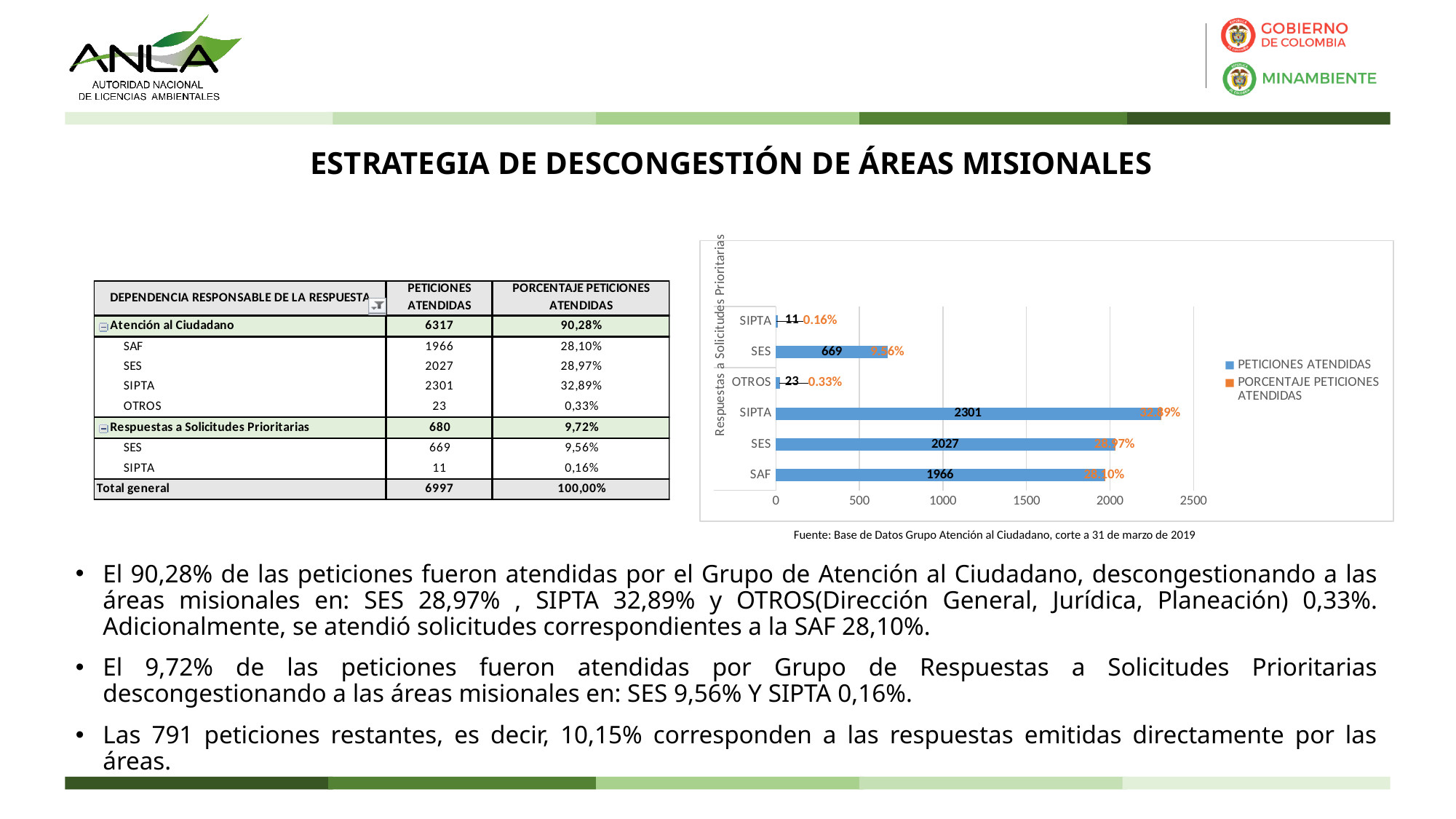
What is the PETICIONES ATENDIDAS value for the SES bar in the Respuestas a Solicitudes Prioritarias group (second bar from the top)? 669 What is the PETICIONES ATENDIDAS value for SAF in the chart? 1966 How many series does the chart legend list? 2 How many bars (categories) are plotted in the chart? 6 What is the PETICIONES ATENDIDAS value for OTROS in the chart? 23 Which bar in the chart has the lowest PETICIONES ATENDIDAS value? SIPTA in the Respuestas a Solicitudes Prioritarias group (11) What is the difference in PETICIONES ATENDIDAS between the SIPTA bar with 2301 and the SES bar with 2027? 274 What PORCENTAJE PETICIONES ATENDIDAS label is shown for OTROS in the chart? 0.33% Is the PETICIONES ATENDIDAS value for the SES bar in the Respuestas a Solicitudes Prioritarias group greater or less than 500? greater Which bar in the chart has the highest PETICIONES ATENDIDAS value? SIPTA (2301) What kind of chart is shown on the slide? bar chart Which has a larger PETICIONES ATENDIDAS value: SAF or the SES bar labelled 2027? SES